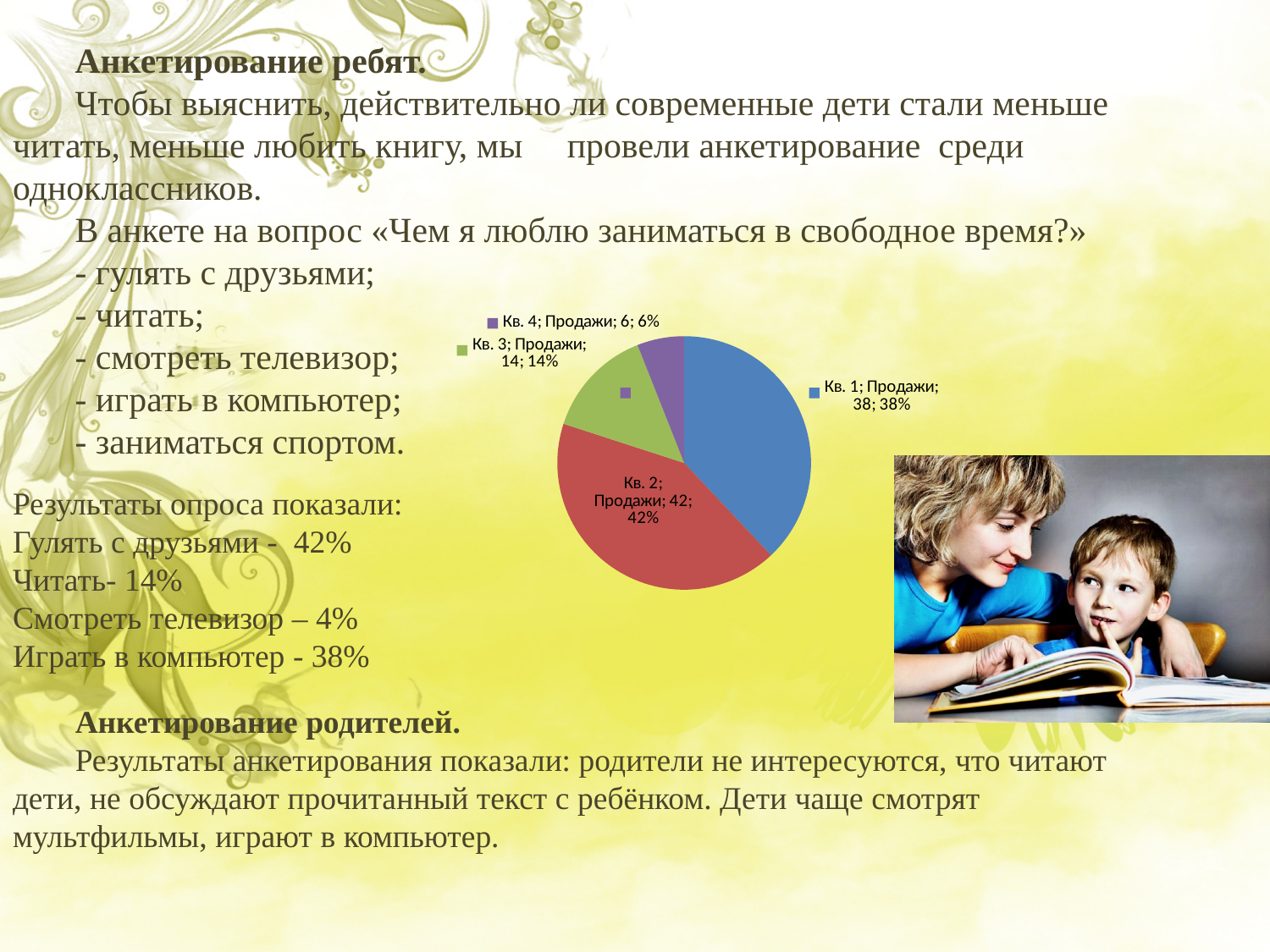
What is the value shown for Кв. 3 in the pie chart? 14 What is the name of the data series shown in the pie chart's labels? Продажи How many slices does the pie chart have? 4 What is the value shown for Кв. 1 in the pie chart? 38 What share of the pie does Кв. 3 represent? 14% Which category has the largest slice in the pie chart? Кв. 2 What is the difference between the values for Кв. 2 and Кв. 1? 4 What is the value shown for Кв. 2 in the pie chart? 42 What kind of chart is shown on the slide? pie chart Which is larger, the value for Кв. 3 or the value for Кв. 4? Кв. 3 Which category has the smallest slice in the pie chart? Кв. 4 What is the value shown for Кв. 4 in the pie chart? 6